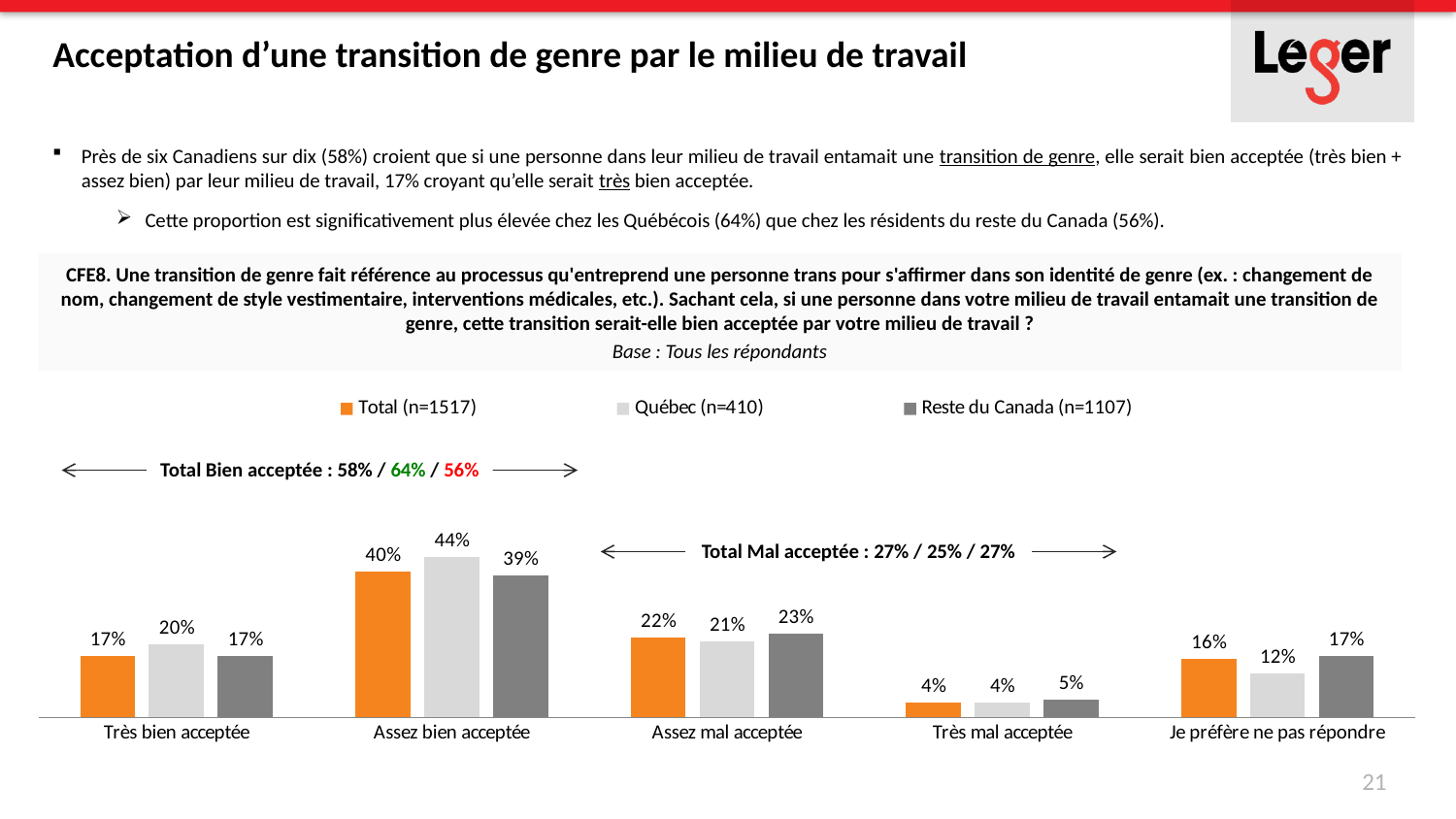
What kind of chart is shown on the slide? Bar chart How many series does the chart legend list? 3 What is the value for Total (n=1517) in the 'Très bien acceptée' category? 17% How many categories are shown on the x axis of the chart? 5 What is the difference between the Québec (n=410) and Reste du Canada (n=1107) values in the 'Assez bien acceptée' category? 5% In the 'Je préfère ne pas répondre' category, which is larger: the Total (n=1517) value or the Québec (n=410) value? Total (n=1517) What is the value for Reste du Canada (n=1107) in the 'Très mal acceptée' category? 5% What is the value for Québec (n=410) in the 'Assez bien acceptée' category? 44% What is the value for Reste du Canada (n=1107) in the 'Je préfère ne pas répondre' category? 17% Which category has the highest value for the Total (n=1517) series? Assez bien acceptée Which category has the lowest value for the Québec (n=410) series? Très mal acceptée According to the annotation above the chart, what is the 'Total Bien acceptée' value for Québec? 64%